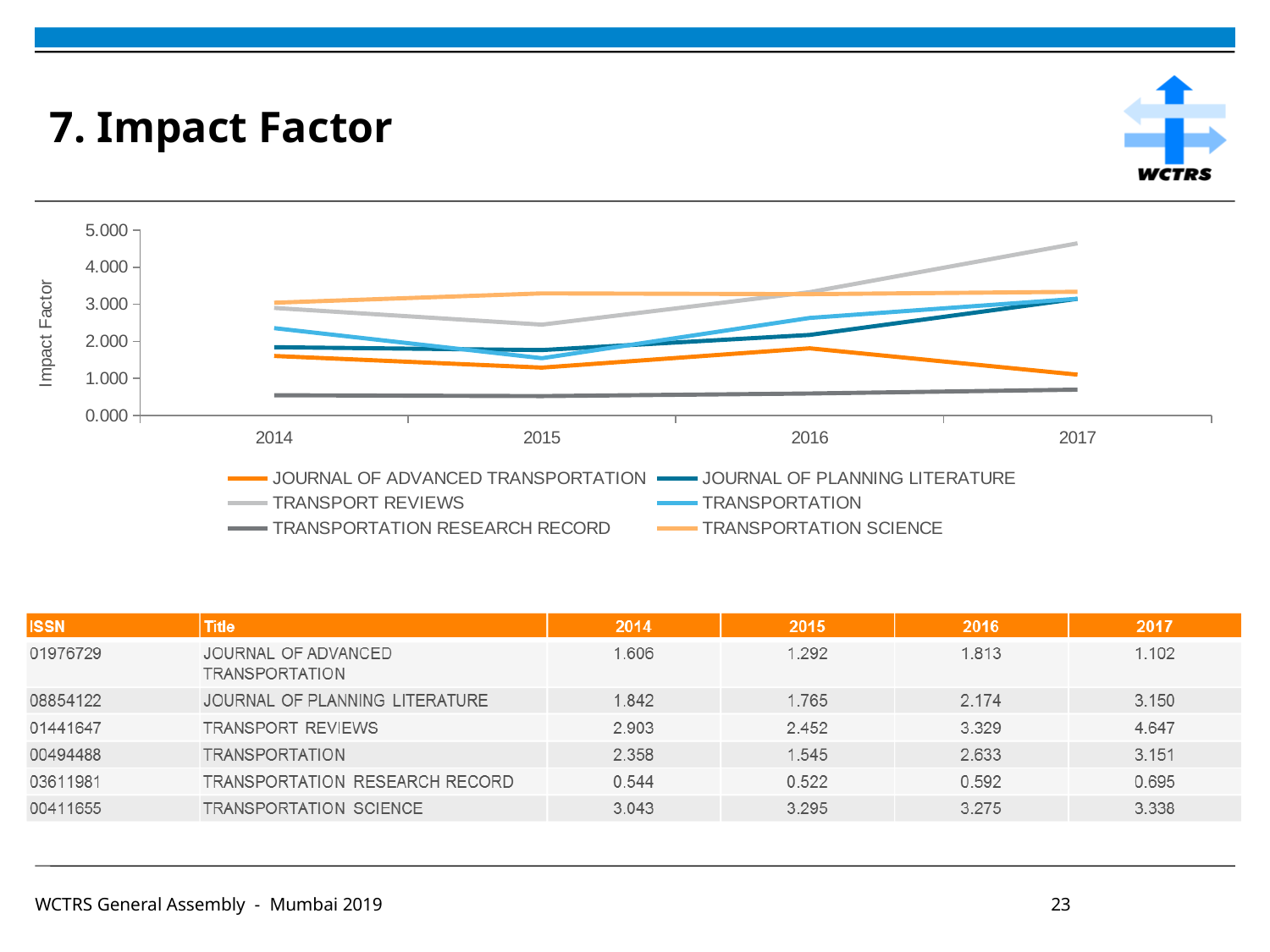
How many years are plotted along the x axis of the chart? 4 What is the impact factor of TRANSPORT REVIEWS in 2017? 4.647 What is the label on the y axis of the chart? Impact Factor What kind of chart is shown on the slide? line chart What is the difference between the 2017 and 2014 impact factors of TRANSPORT REVIEWS? 1.744 Is the 2017 impact factor of JOURNAL OF ADVANCED TRANSPORTATION greater or less than 2.000? less Which journal has the highest impact factor in 2017? TRANSPORT REVIEWS Does the impact factor of JOURNAL OF ADVANCED TRANSPORTATION rise or fall from 2016 to 2017? fall How many series does the chart legend list? 6 Which has the larger impact factor in 2016, TRANSPORTATION SCIENCE or TRANSPORTATION? TRANSPORTATION SCIENCE Which journal has the lowest impact factor in 2014? TRANSPORTATION RESEARCH RECORD What is the impact factor of TRANSPORTATION RESEARCH RECORD in 2015? 0.522